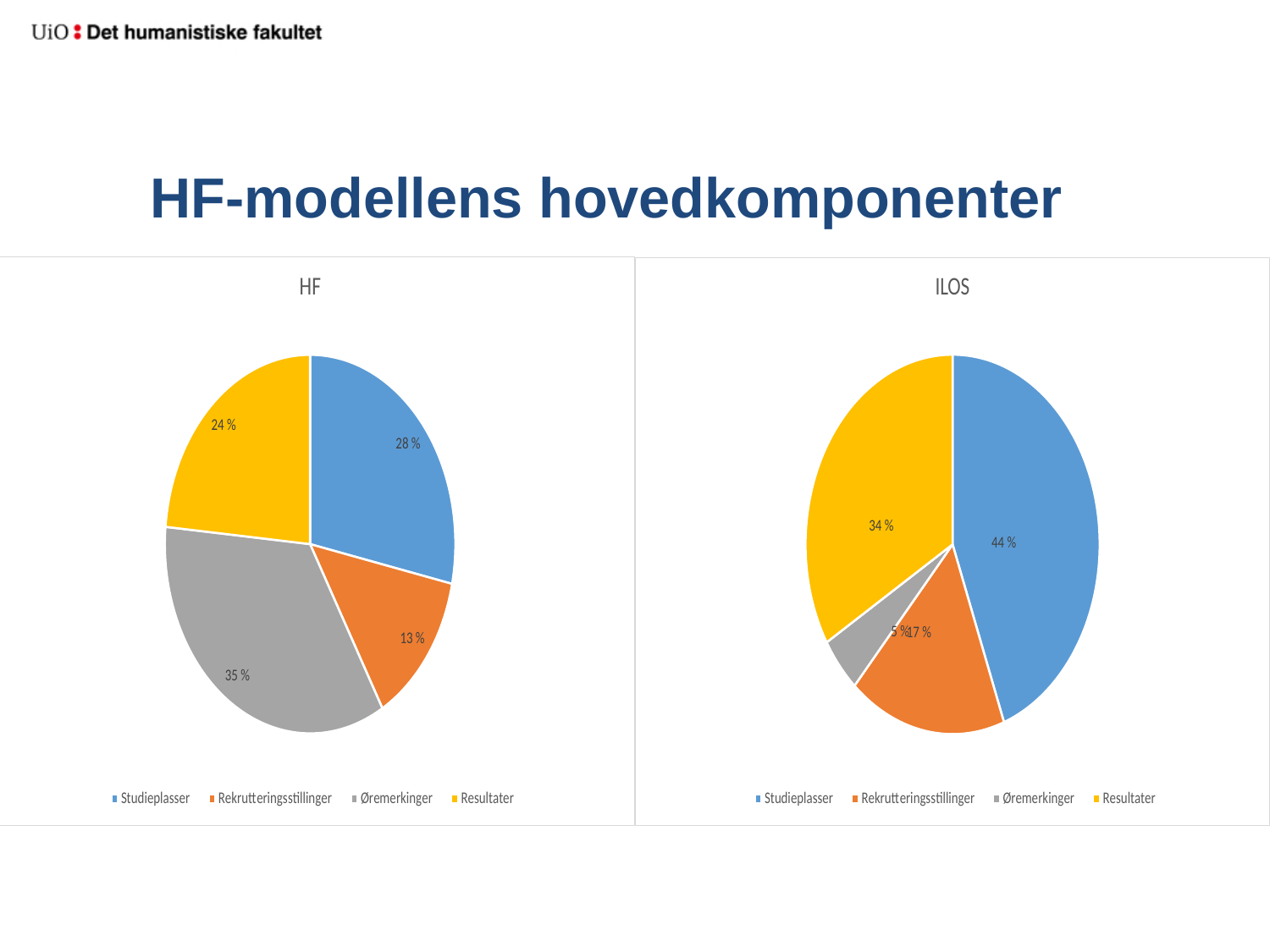
What type of chart is the HF chart? Pie chart In the ILOS chart, what share does Resultater have? 34 % In the ILOS chart, which category has the largest slice? Studieplasser In the HF chart, which is larger: Resultater or Rekrutteringsstillinger? Resultater In the HF chart, what share does Studieplasser have? 28 % In the HF chart, which category has the smallest slice? Rekrutteringsstillinger In the ILOS chart, what share does Studieplasser have? 44 % In the HF chart, what share does Øremerkinger have? 35 % In the ILOS chart, which category has the smallest slice? Øremerkinger What is the difference in percentage points between Studieplasser in the ILOS chart and Studieplasser in the HF chart? 16 How many categories does the legend of the ILOS chart list? 4 In the HF chart, which category has the largest slice? Øremerkinger